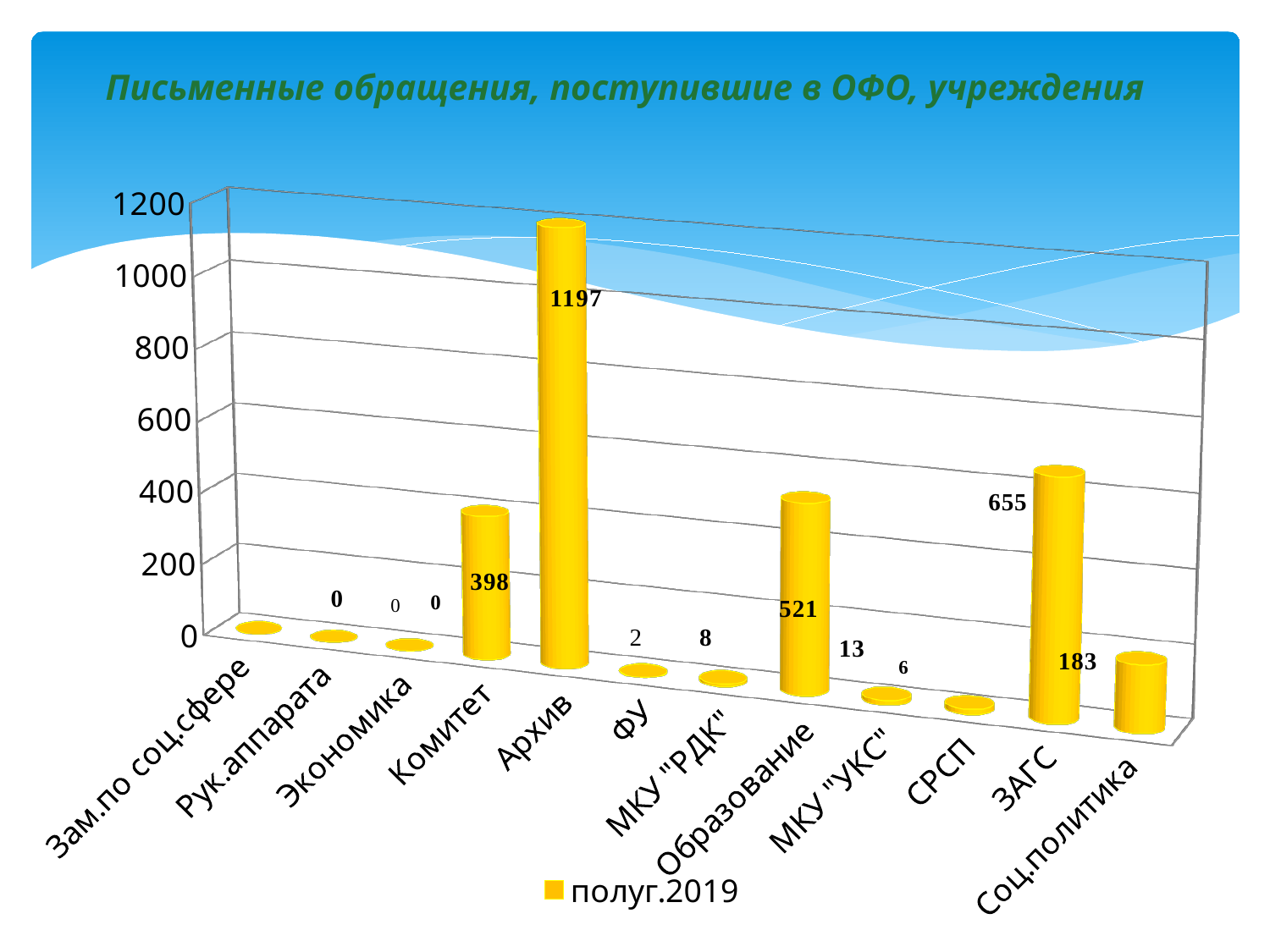
What kind of chart is shown? bar chart Which category has the highest value? Архив Is the value for Комитет greater or less than 200? greater What is the value for Соц.политика? 183 How many categories are shown on the x axis? 12 What is the value for Образование? 521 Which is larger, the value for Комитет or the value for Соц.политика? Комитет What is the difference between the values for ЗАГС and Образование? 134 What is the legend entry for the series? полуг.2019 What is the value for ЗАГС? 655 What is the value for Архив? 1197 How many series does the legend list? 1